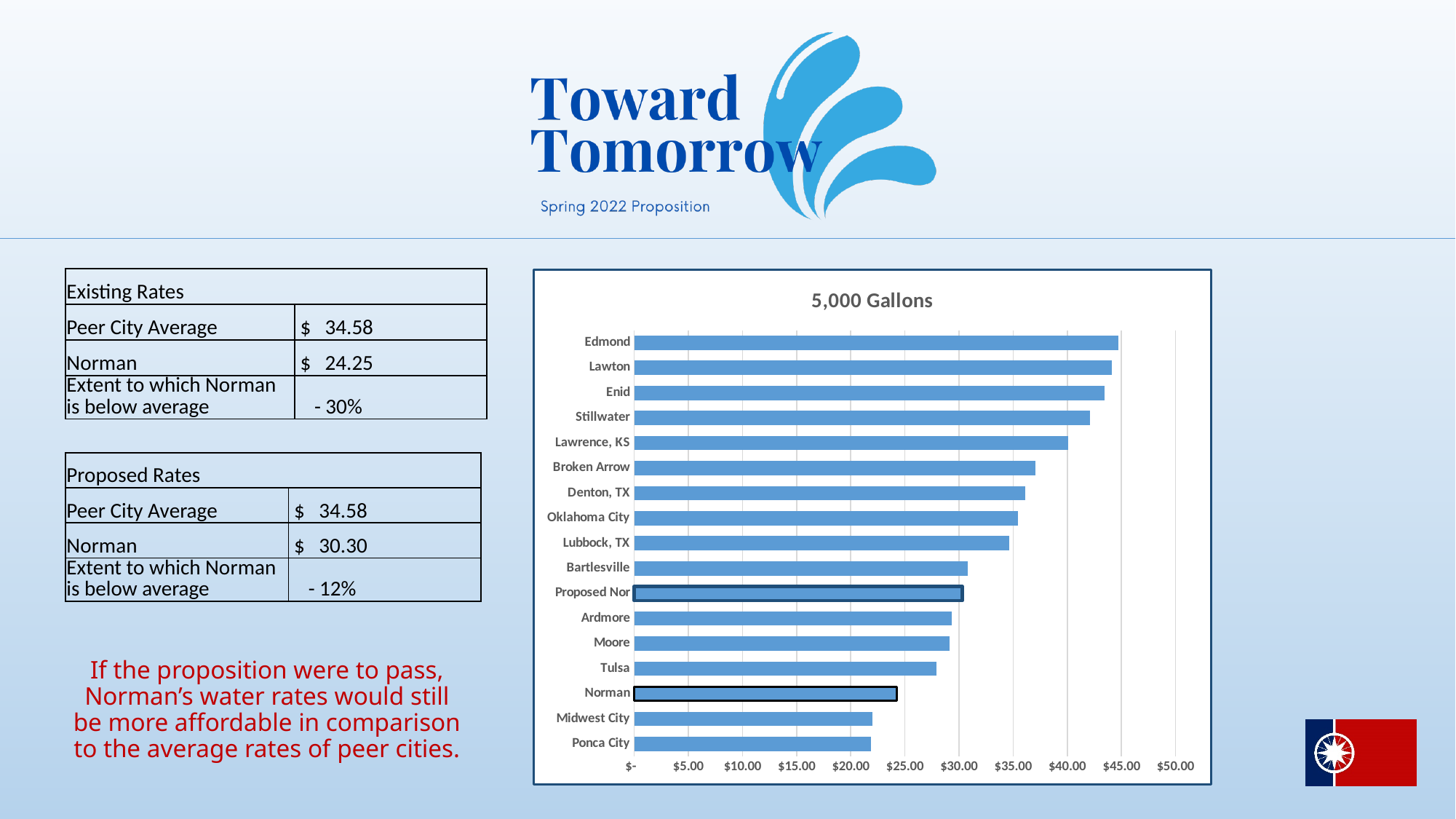
What type of chart is shown on the slide? bar chart Is the value for Edmond greater or less than $40.00? greater Is the value for Broken Arrow greater or less than $35.00? greater Which has the larger value, Proposed Norman or Norman? Proposed Norman Which has the larger value, Tulsa or Stillwater? Stillwater Do the bar values increase or decrease going from the top of the chart (Edmond) to the bottom (Ponca City)? decrease How many cities (categories) are plotted in the chart? 17 Which city has the highest value in the chart? Edmond What is the title of the chart? 5,000 Gallons Is the value for Stillwater greater or less than $40.00? greater